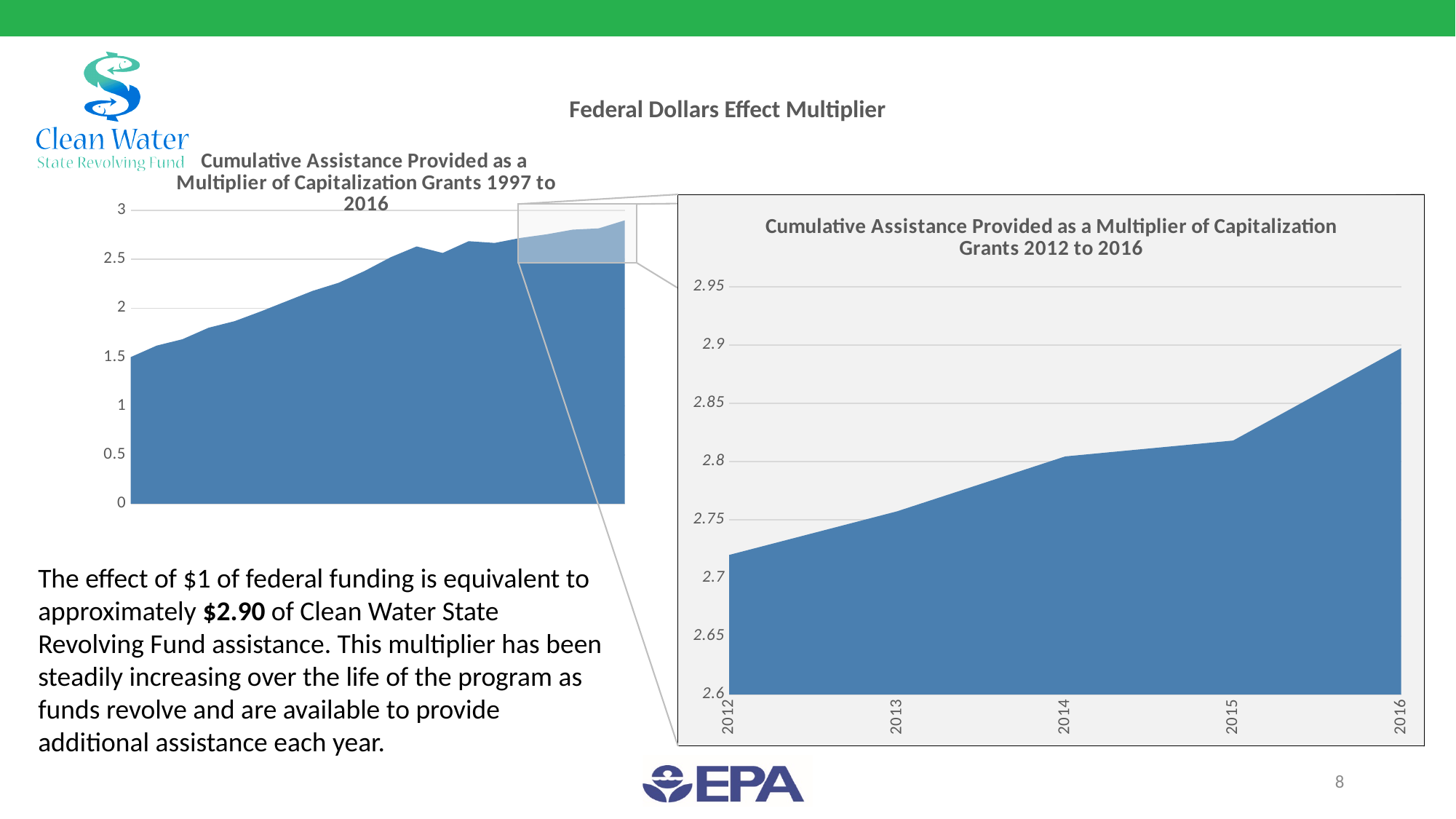
In the right-hand chart (2012 to 2016), which year has the highest multiplier value? 2016 In the right-hand chart (2012 to 2016), is the value for 2012 greater or less than 2.75? less In the right-hand chart (2012 to 2016), which is larger, the value for 2014 or the value for 2016? 2016 In the right-hand chart (2012 to 2016), is the value for 2016 greater or less than 2.85? greater In the right-hand chart (2012 to 2016), how many years are shown on the x axis? 5 In the right-hand chart (2012 to 2016), is the value for 2015 greater or less than 2.85? less What type of chart is the 'Cumulative Assistance Provided as a Multiplier of Capitalization Grants 2012 to 2016' chart on the right? Area chart In the left-hand chart (1997 to 2016), do the values generally rise or fall along the x axis? Rise In the right-hand chart (2012 to 2016), which year has the lowest multiplier value? 2012 In the right-hand chart (2012 to 2016), do the values rise or fall from 2012 to 2016? Rise What is the highest value shown on the y axis of the left-hand chart (1997 to 2016)? 3